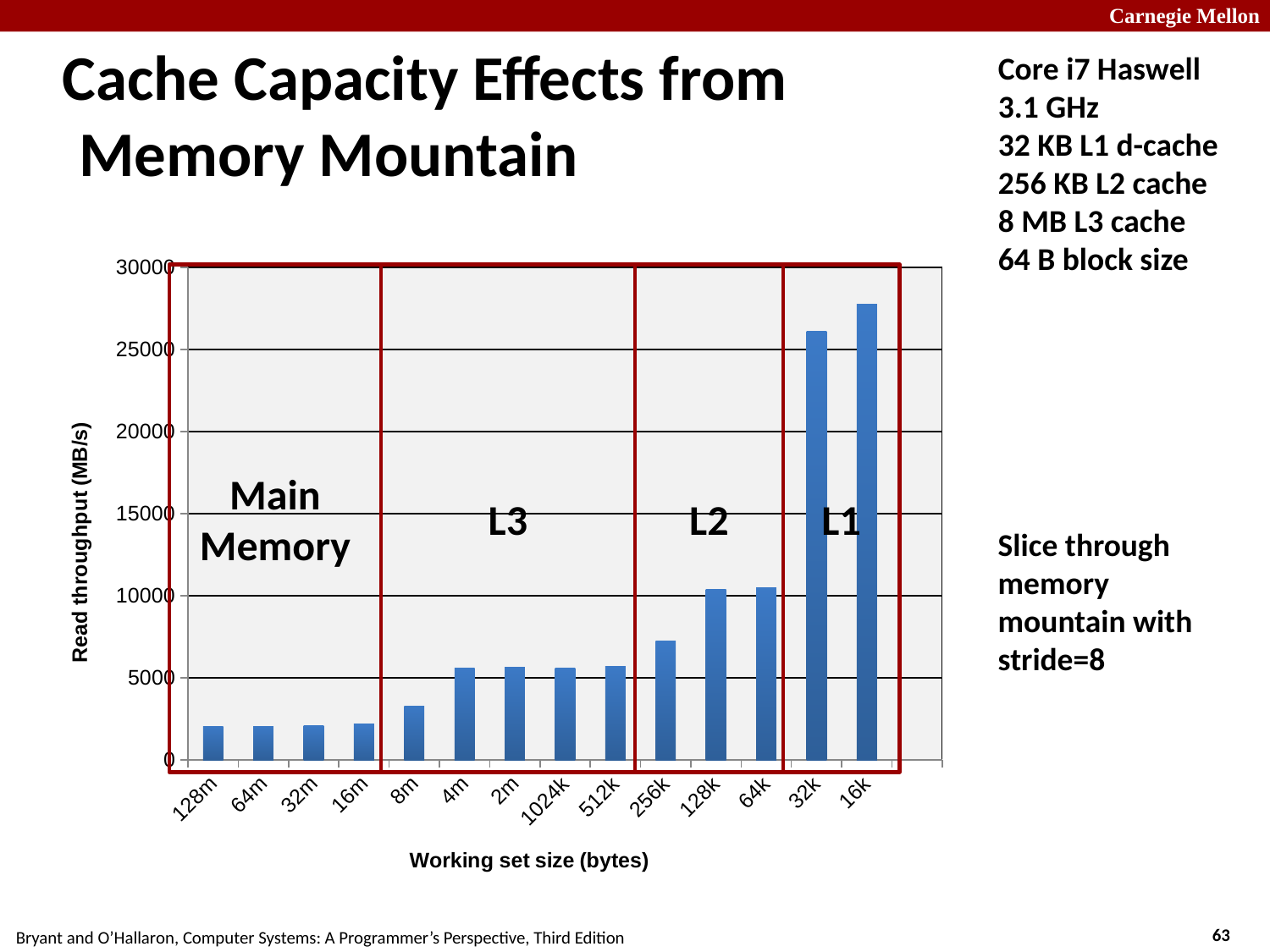
What kind of chart is shown on the slide? bar chart What is the label of the y axis? Read throughput (MB/s) How many working set sizes are plotted along the x axis? 14 Is the read throughput for 128m greater or less than 5000? less Which has the larger read throughput, 8m or 4m? 4m Is the read throughput for 256k greater or less than 5000? greater Is the read throughput for 32k greater or less than 20000? greater Do the read throughput values generally rise or fall moving from left to right along the x axis? rise Which working set size has the highest read throughput? 16k Which has the larger read throughput, 32k or 256k? 32k